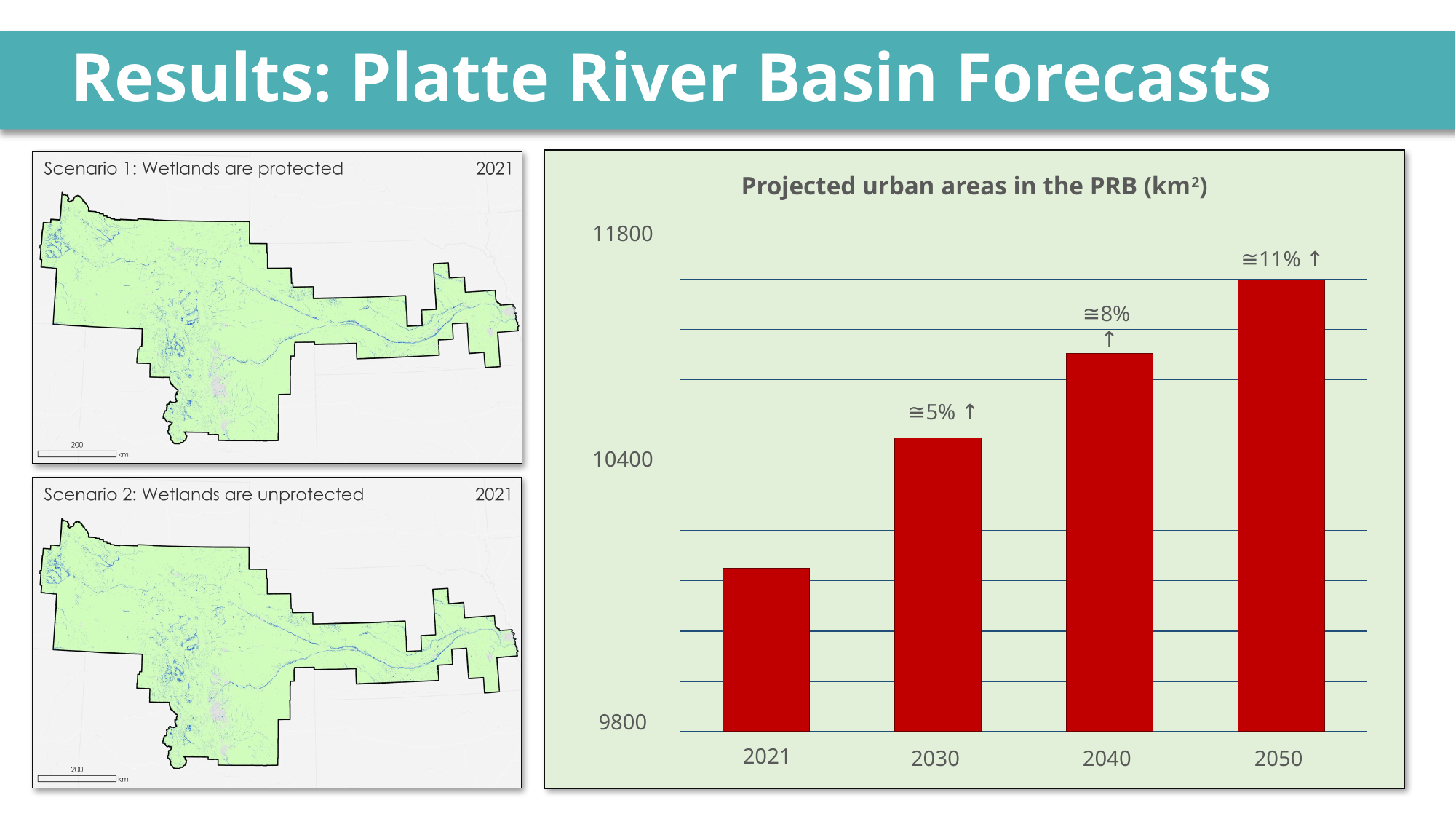
In the 'Projected urban areas in the PRB (km²)' chart, which year has the highest projected urban area? 2050 In the 'Projected urban areas in the PRB (km²)' chart, is the value for 2050 greater or less than 11800? less How many years are shown on the x axis of the 'Projected urban areas in the PRB (km²)' chart? 4 What is the title of the bar chart on the right of the slide? Projected urban areas in the PRB (km²) In the 'Projected urban areas in the PRB (km²)' chart, what percentage increase is labelled above the 2030 bar? ≅5% In the 'Projected urban areas in the PRB (km²)' chart, which is larger, the value for 2030 or the value for 2040? 2040 In the 'Projected urban areas in the PRB (km²)' chart, is the value for 2040 greater or less than 10400? greater What kind of chart is 'Projected urban areas in the PRB (km²)'? bar chart In the 'Projected urban areas in the PRB (km²)' chart, which year has the lowest projected urban area? 2021 In the 'Projected urban areas in the PRB (km²)' chart, what percentage increase is labelled above the 2050 bar? ≅11% In the 'Projected urban areas in the PRB (km²)' chart, do the values rise or fall from 2021 to 2050? rise